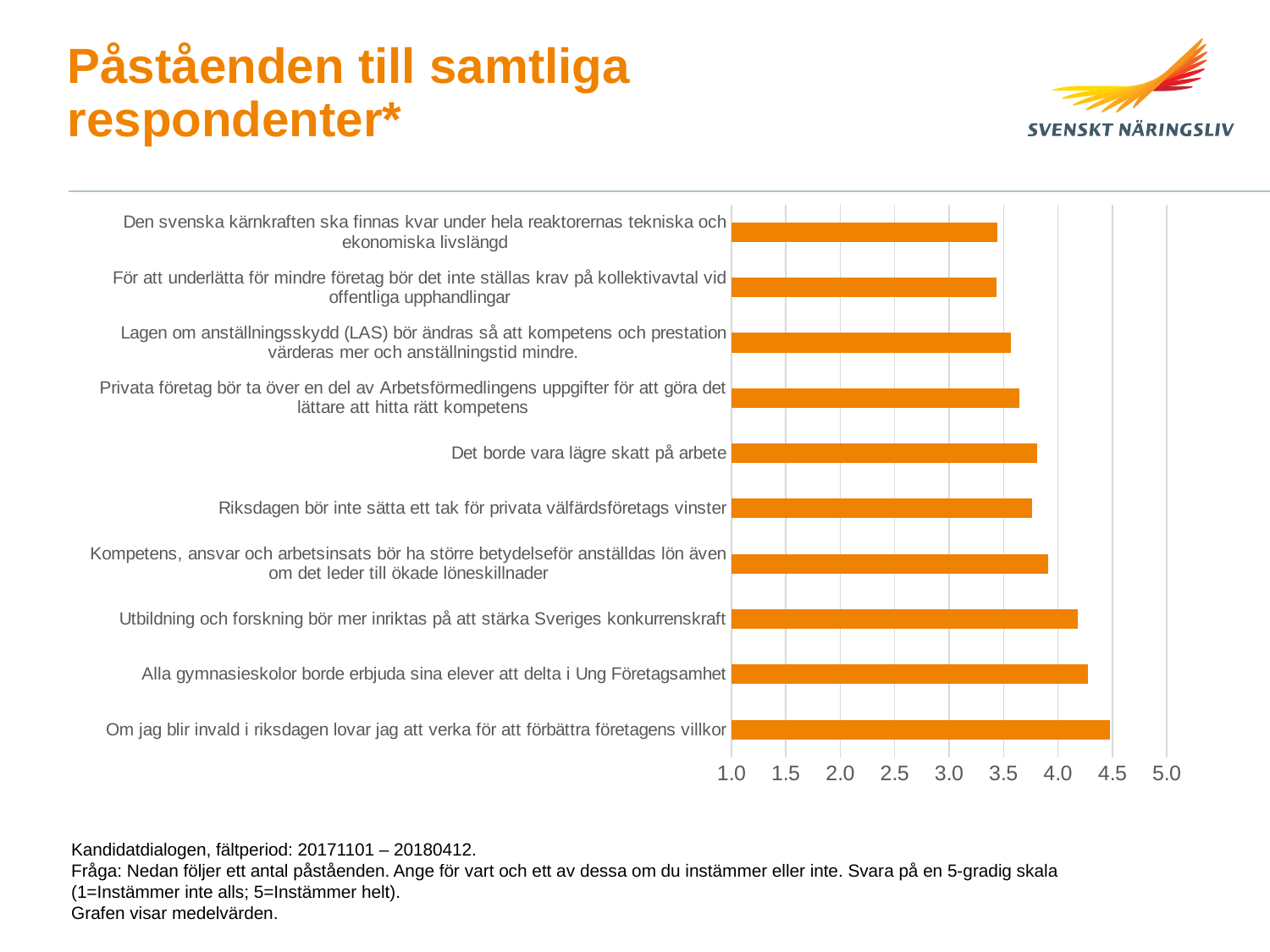
What kind of chart is shown on the slide? Bar chart Is the value for "Den svenska kärnkraften ska finnas kvar under hela reaktorernas tekniska och ekonomiska livslängd" greater or less than 3.5? less Is the value for "Utbildning och forskning bör mer inriktas på att stärka Sveriges konkurrenskraft" greater or less than 4.0? greater Is the value for "För att underlätta för mindre företag bör det inte ställas krav på kollektivavtal vid offentliga upphandlingar" greater or less than 4.0? less Which statement has the highest mean value in the chart? Om jag blir invald i riksdagen lovar jag att verka för att förbättra företagens villkor What colour are the bars in the chart? Orange Which has the larger value: "Utbildning och forskning bör mer inriktas på att stärka Sveriges konkurrenskraft" or "Det borde vara lägre skatt på arbete"? Utbildning och forskning bör mer inriktas på att stärka Sveriges konkurrenskraft Which has the larger value: "Om jag blir invald i riksdagen lovar jag att verka för att förbättra företagens villkor" or "Privata företag bör ta över en del av Arbetsförmedlingens uppgifter för att göra det lättare att hitta rätt kompetens"? Om jag blir invald i riksdagen lovar jag att verka för att förbättra företagens villkor How many statements (categories) are plotted in the chart? 10